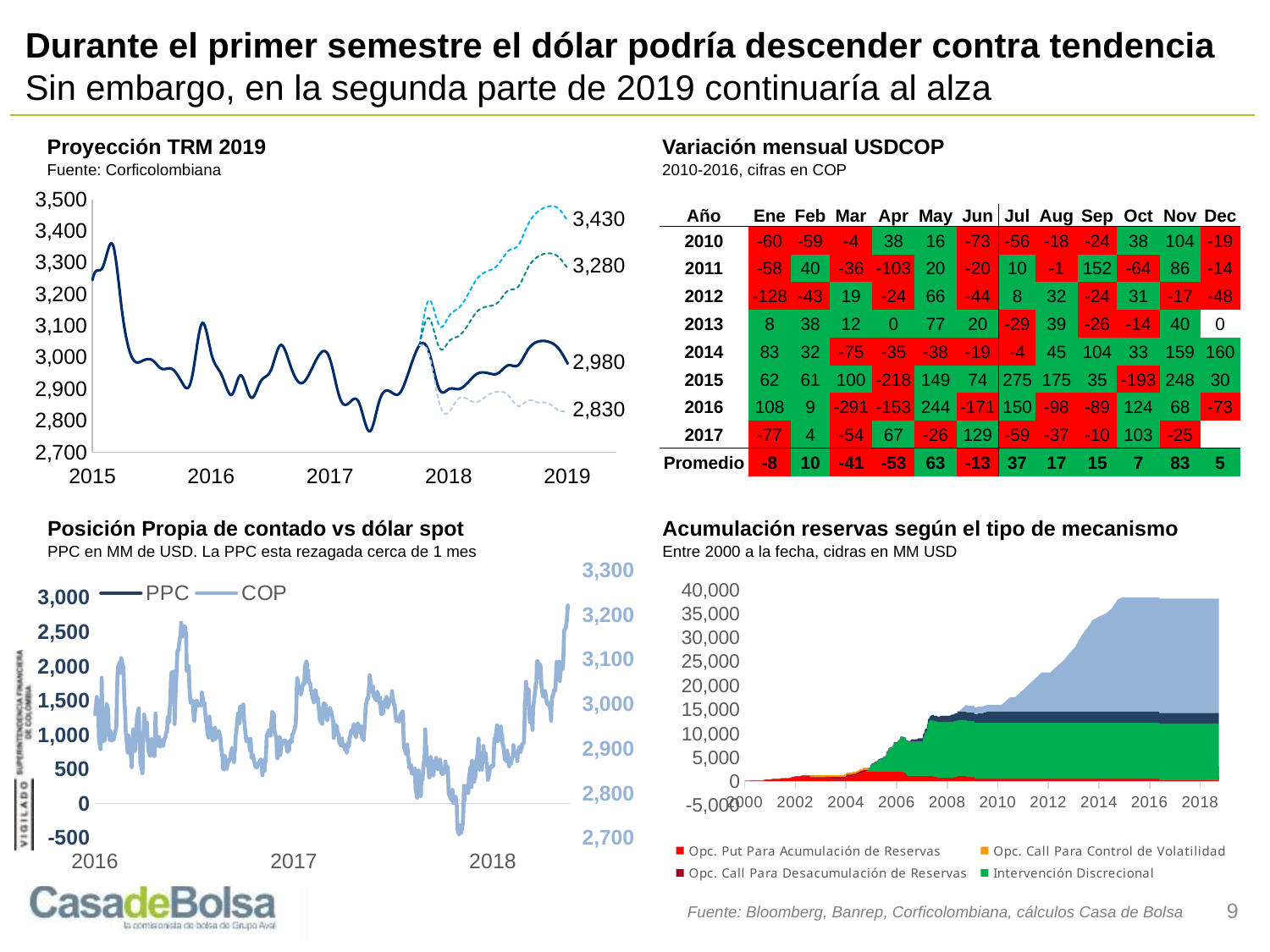
How many year labels appear on the x axis of the 'Proyección TRM 2019' chart? 5 In the 'Proyección TRM 2019' chart, what is the difference between the labelled values 3,280 and 2,980? 300 In the 'Proyección TRM 2019' chart, what is the highest value labelled at the end of 2019? 3,430 In the 'Acumulación reservas según el tipo de mecanismo' chart, is the total accumulated value in 2018 greater or less than 35,000? greater What kind of chart is 'Acumulación reservas según el tipo de mecanismo'? Stacked area chart What are the two legend entries in the 'Posición Propia de contado vs dólar spot' chart? PPC and COP What kind of chart is 'Proyección TRM 2019'? Line chart How many series does the legend of the 'Posición Propia de contado vs dólar spot' chart list? 2 In the 'Proyección TRM 2019' chart, what is the lowest value labelled at the end of 2019? 2,830 In the 'Proyección TRM 2019' chart, what is the difference between the highest (3,430) and lowest (2,830) labelled 2019 values? 600 In the 'Acumulación reservas según el tipo de mecanismo' chart, does the total accumulated value rise or fall from 2000 to 2018? rise How many entries does the legend of the 'Acumulación reservas según el tipo de mecanismo' chart list? 4